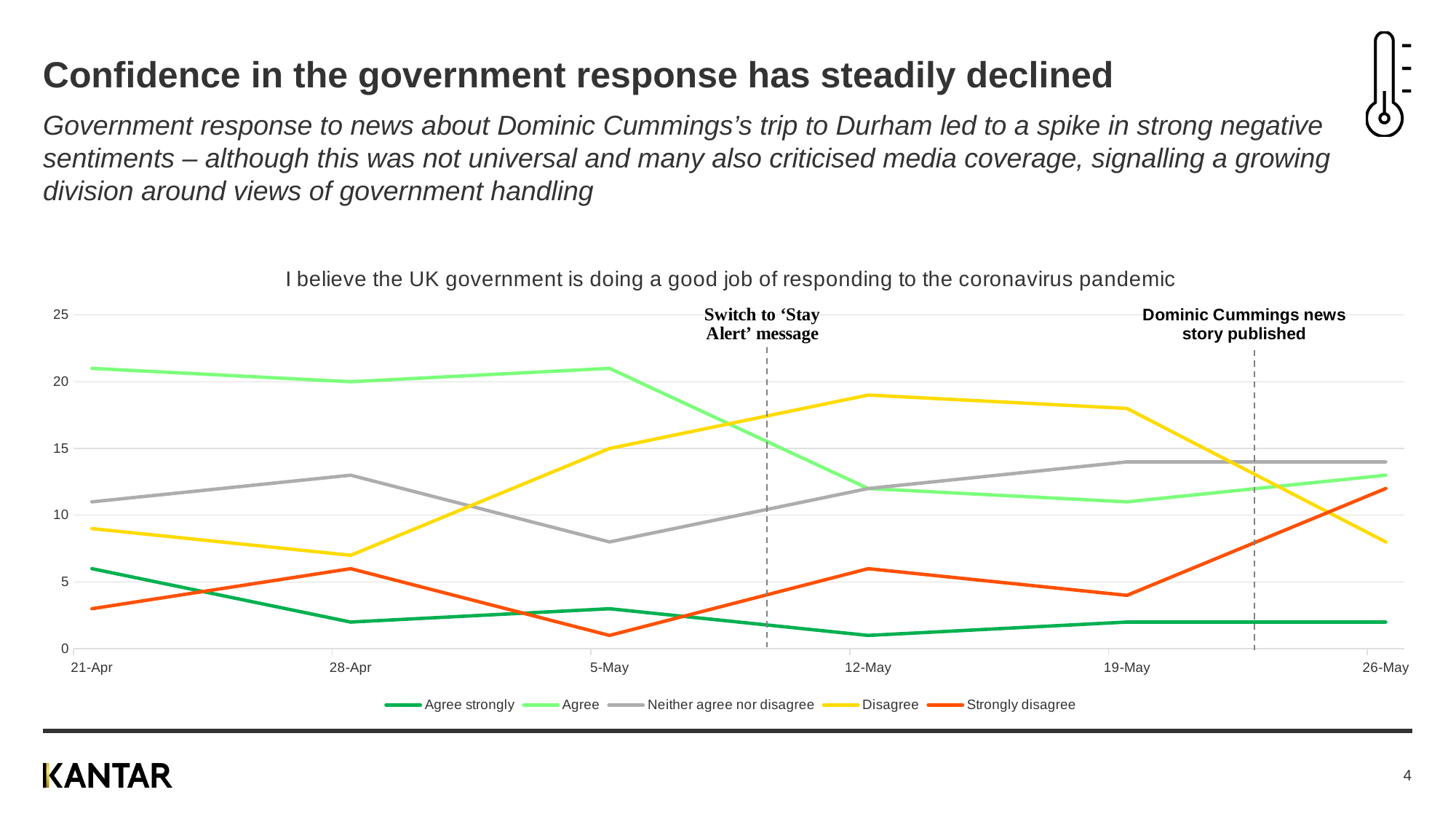
Which series has the highest value on 12-May? Disagree Which series has the lowest value on 26-May? Agree strongly Does the Disagree line rise or fall from 28-Apr to 12-May? rise What kind of chart is shown on the slide? line chart What is the value for Agree on 28-Apr? 20 On 19-May, which is larger: Disagree or Agree? Disagree Is the value for Disagree on 28-Apr greater or less than 10? less How many dates are shown along the x axis? 6 What is the title of the chart? I believe the UK government is doing a good job of responding to the coronavirus pandemic How many series does the legend list? 5 Is the value for Strongly disagree on 26-May greater or less than 10? greater What is the value for Disagree on 5-May? 15